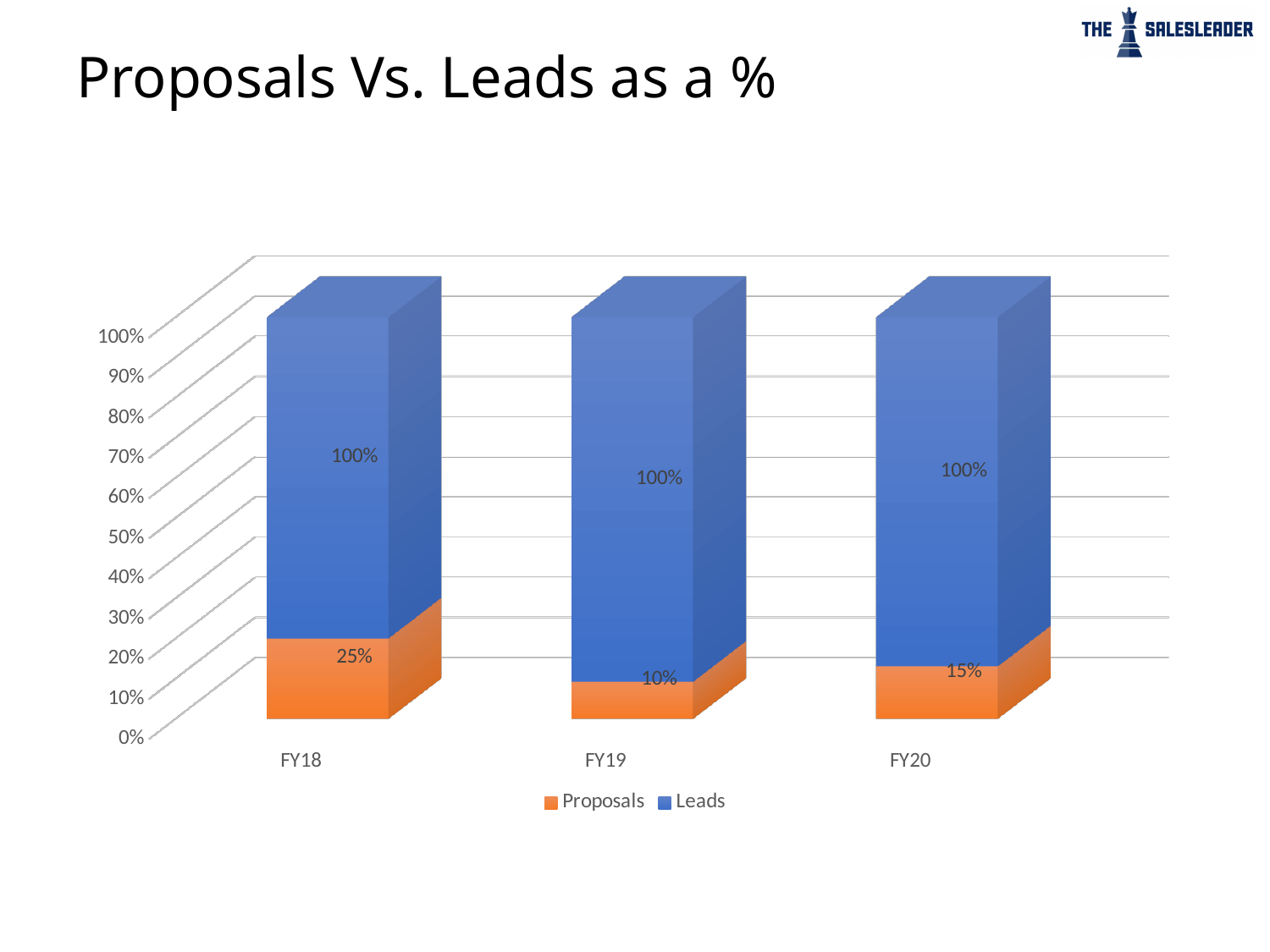
Which fiscal year has the highest Proposals value? FY18 How many fiscal years are shown on the x axis? 3 What is the difference between the Proposals values for FY18 and FY19? 15% What kind of chart is shown on the slide? Stacked bar chart What is the title of the slide? Proposals Vs. Leads as a % What is the Proposals value for FY18? 25% Which fiscal year has the lowest Proposals value? FY19 What is the Proposals value for FY20? 15% How many series does the legend list? 2 What is the Leads value for FY19? 100% Which is larger, the Proposals value for FY20 or for FY19? FY20 What is the Proposals value for FY19? 10%